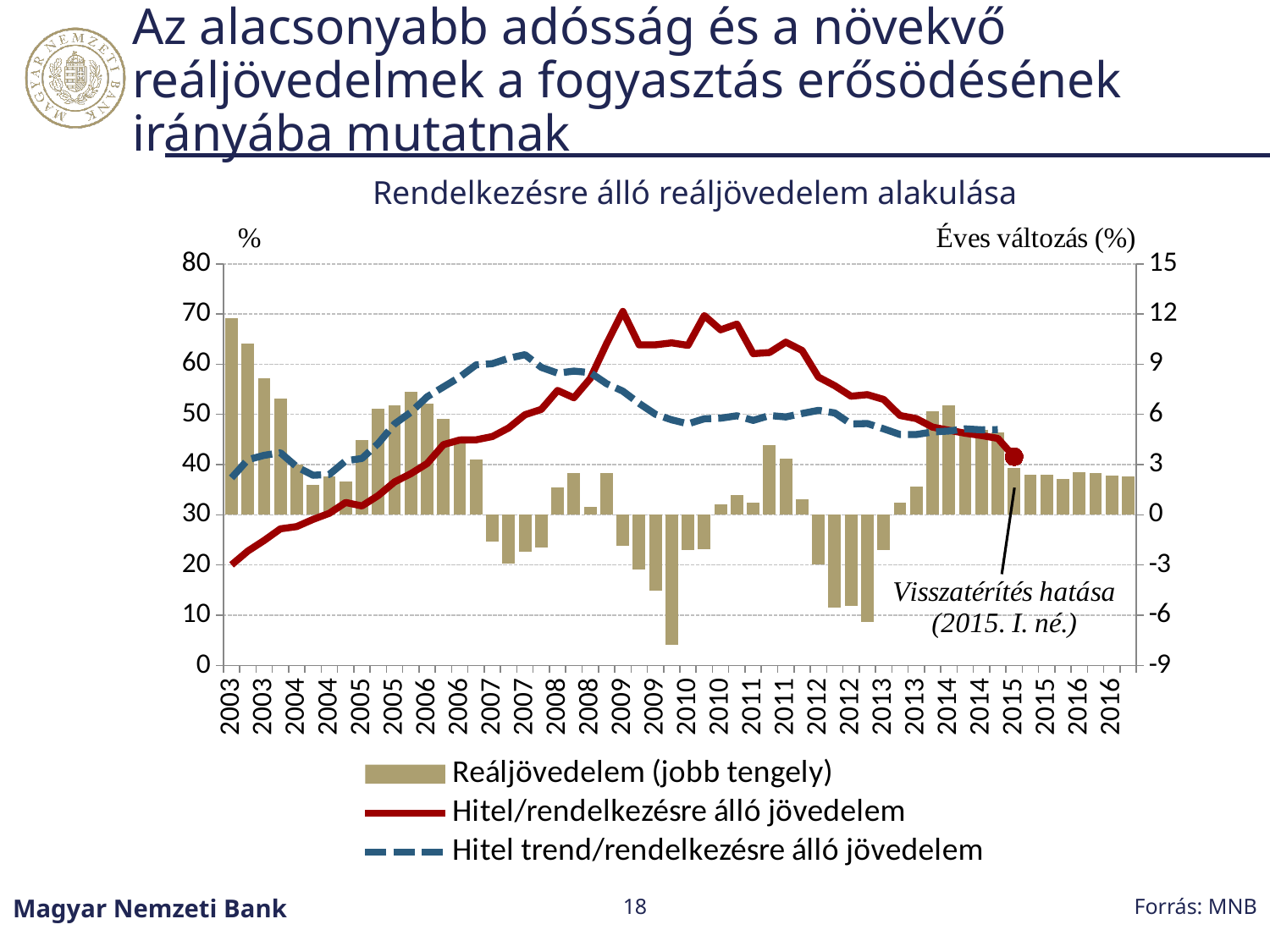
What kind of chart is shown on the slide? A combined bar and line chart In 2007, which is higher: the Hitel/rendelkezésre álló jövedelem line or the Hitel trend/rendelkezésre álló jövedelem line? Hitel trend/rendelkezésre álló jövedelem Does the Hitel/rendelkezésre álló jövedelem line rise or fall between 2011 and 2015? fall Is the first Reáljövedelem bar in 2003 greater or less than 9 on the right axis? greater Does the Hitel/rendelkezésre álló jövedelem line rise or fall between 2003 and 2009? rise Is the value of the Hitel/rendelkezésre álló jövedelem line at the start of 2003 greater or less than 30? less What is the title of the chart? Rendelkezésre álló reáljövedelem alakulása Which series is plotted on the right axis according to the legend? Reáljövedelem (jobb tengely) Which line reaches the higher peak on the left axis: Hitel/rendelkezésre álló jövedelem or Hitel trend/rendelkezésre álló jövedelem? Hitel/rendelkezésre álló jövedelem Is the lowest Reáljövedelem bar (around 2009–2010) greater or less than -6 on the right axis? less How many series does the legend list? 3